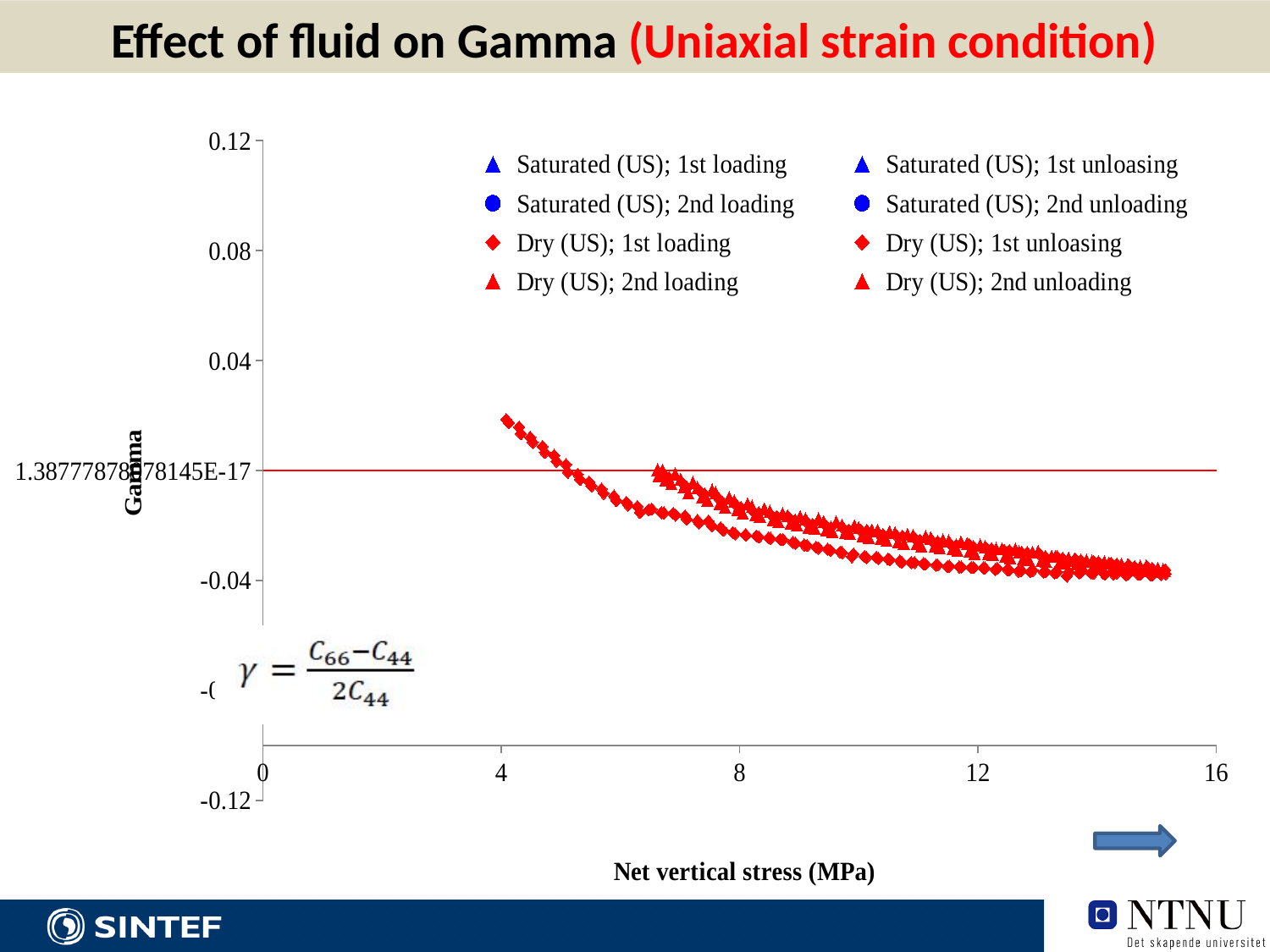
Are the plotted Gamma values at a net vertical stress of 8 MPa greater or less than 0.04? less What is the label of the x axis? Net vertical stress (MPa) Is the Gamma value for Dry (US); 1st loading at a net vertical stress of about 4 MPa greater or less than 0? greater What is the highest value shown on the x axis? 16 Do the plotted Gamma values rise or fall as net vertical stress increases? fall What is the label of the y axis? Gamma How many series does the legend list? 8 Is the Gamma value for Dry (US); 1st loading at a net vertical stress of 12 MPa greater or less than 0? less What kind of chart is shown on the slide? scatter chart